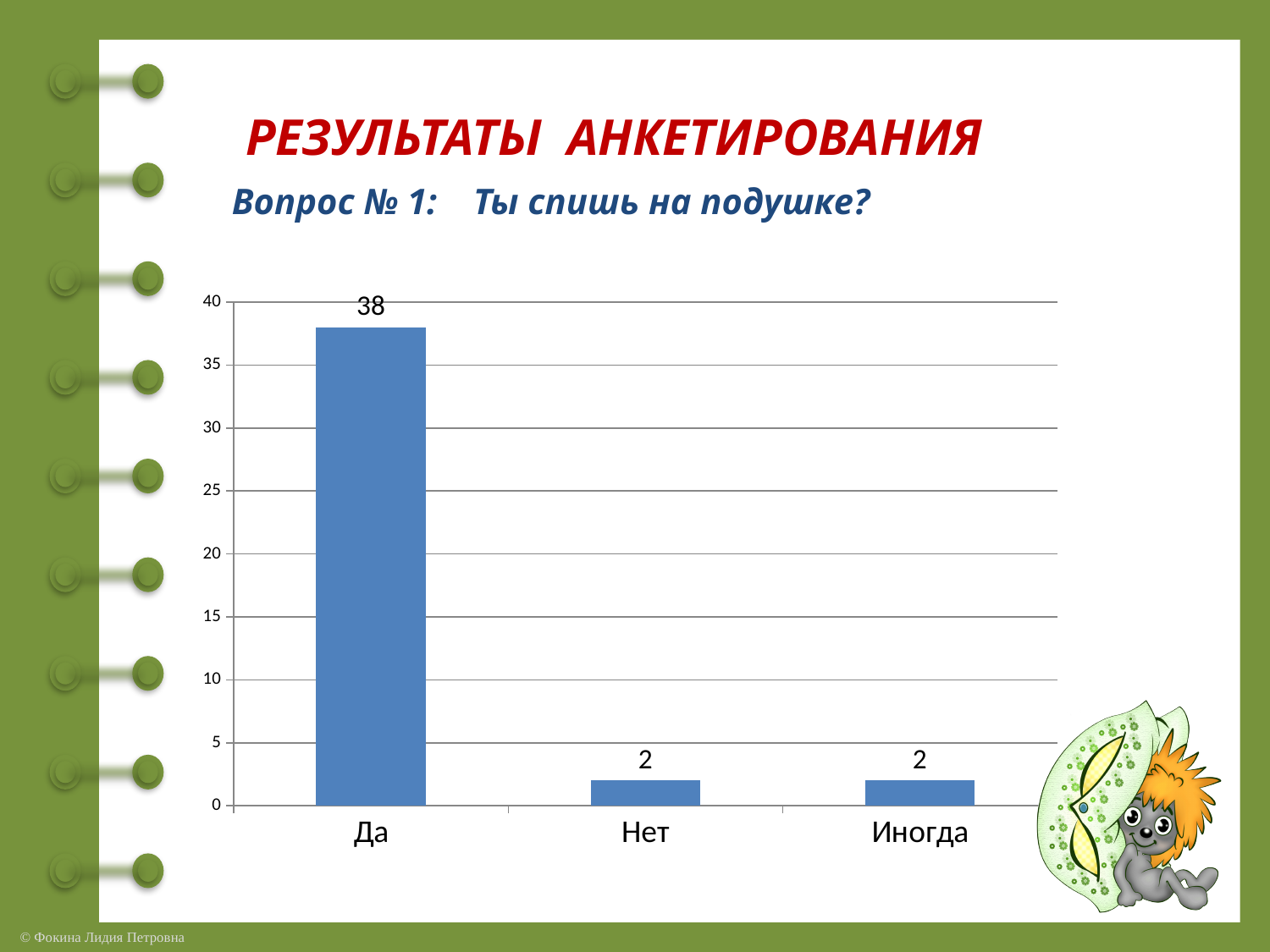
Which category has the highest value? Да How many categories are shown on the x axis? 3 What is the value for Да? 38 What kind of chart is shown on the slide? bar chart Is the value for Да greater or less than 35? greater What is the value for Иногда? 2 What question is the chart about, as stated above it? Ты спишь на подушке? What is the value for Нет? 2 What is the difference between the values for Да and Нет? 36 What is the total of the values for all three categories? 42 Which is larger, the value for Да or the value for Иногда? Да Is the value for Нет greater or less than 5? less